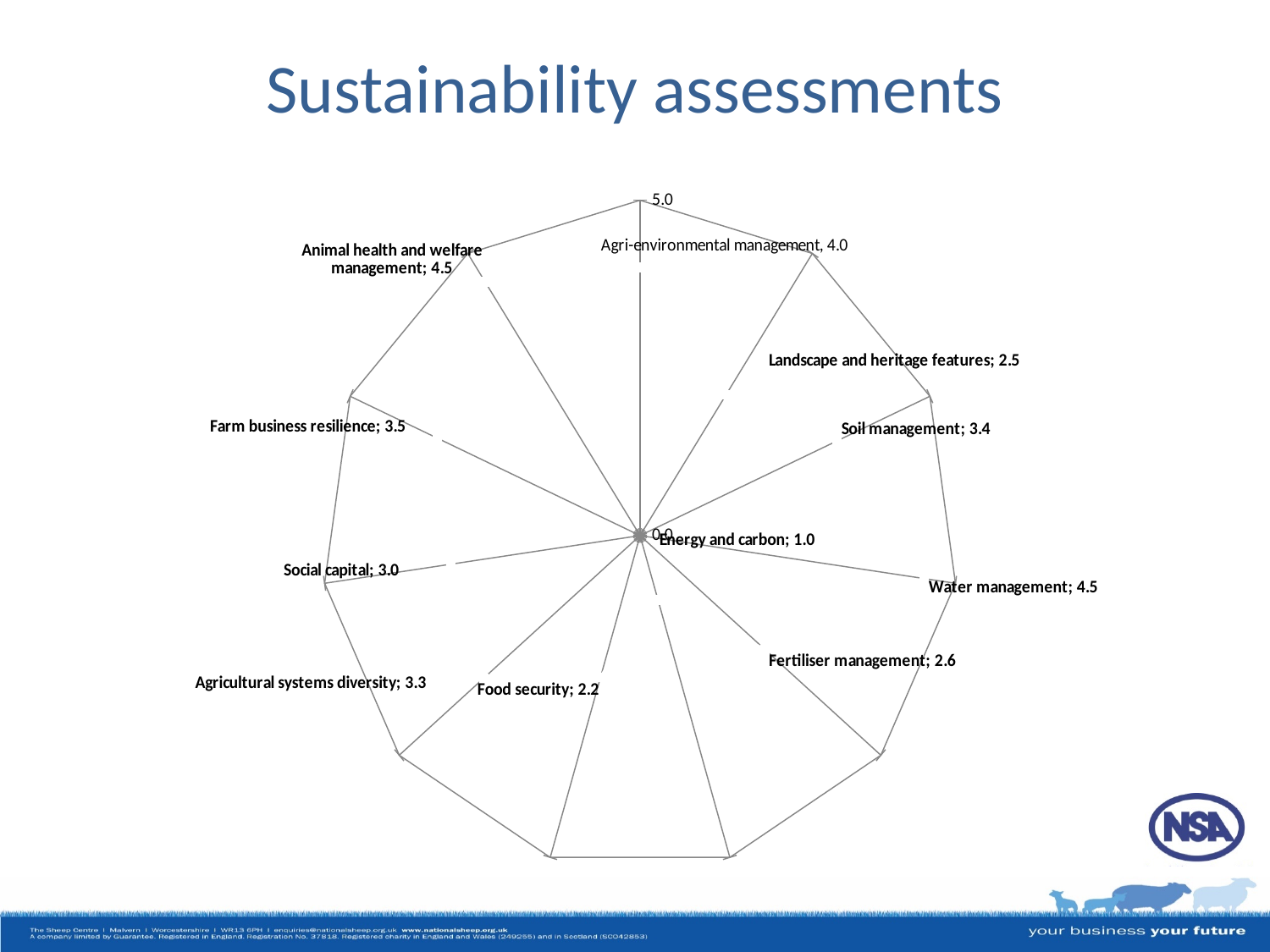
Which has a larger value, Social capital or Landscape and heritage features? Social capital What is the value for Agri-environmental management? 4.0 What is the maximum value shown on the chart's axis? 5.0 Which category has the lowest value? Energy and carbon What is the value for Farm business resilience? 3.5 What is the value for Energy and carbon? 1.0 What is the value for Soil management? 3.4 What is the title of the slide containing the chart? Sustainability assessments What is the value for Food security? 2.2 What type of chart is shown on the slide? Radar chart How many categories are plotted on the chart? 11 What is the difference between the values for Water management and Fertiliser management? 1.9